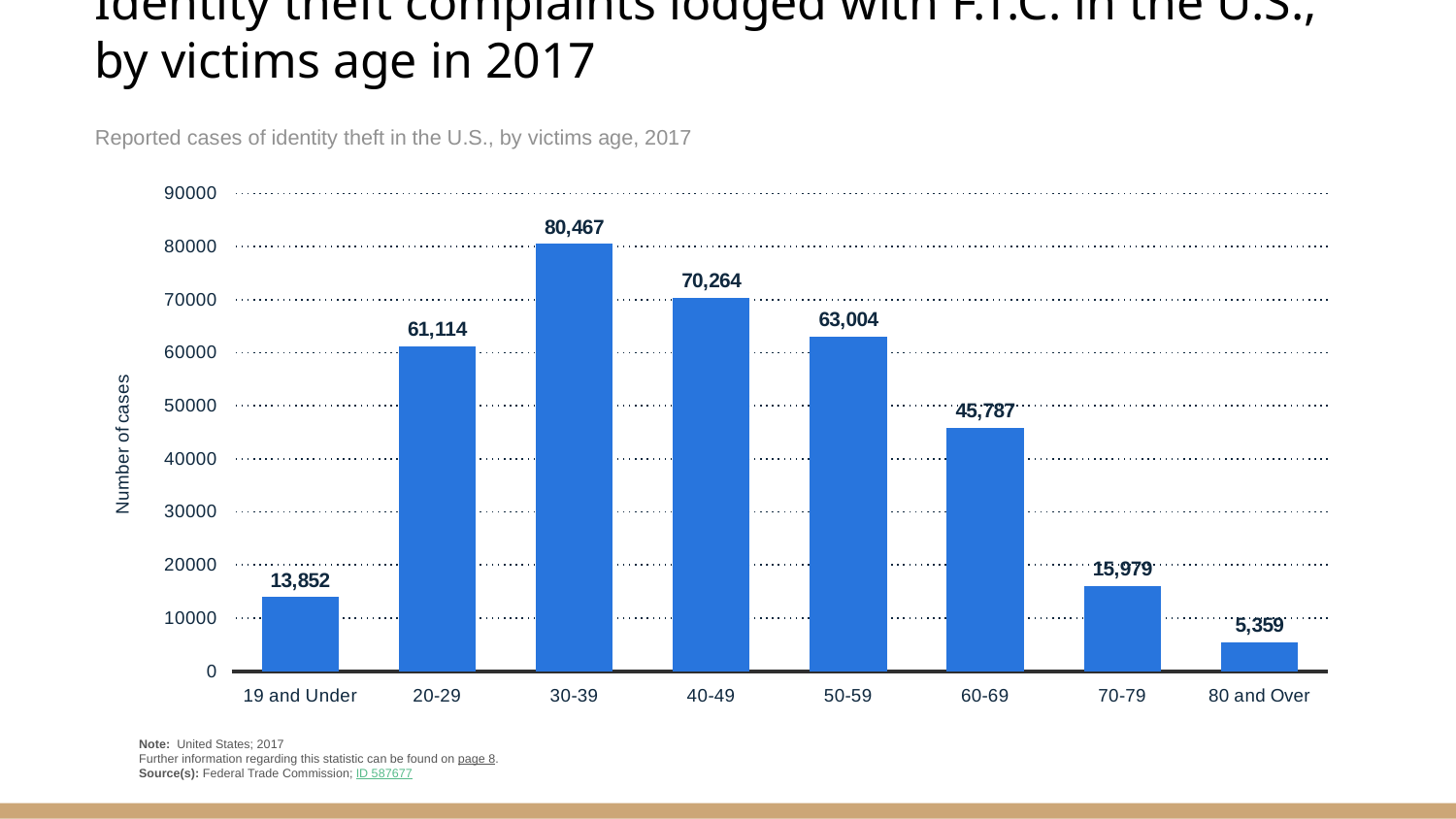
Which age group has the highest number of identity theft cases? 30-39 Is the value for the 60-69 age group greater or less than 50000? less What is the number of identity theft cases for victims aged 30-39? 80,467 What is the number of cases for the 80 and Over age group? 5,359 How many cases are reported for the 19 and Under age group? 13,852 How many age groups are shown on the chart? 8 Which age group has the lowest number of identity theft cases? 80 and Over What type of chart is shown on the slide? Bar chart What is the difference in cases between the 60-69 and 70-79 age groups? 29,808 What is the label of the vertical axis? Number of cases Which age group has more cases, 20-29 or 50-59? 50-59 What is the difference in cases between the 30-39 and 40-49 age groups? 10,203